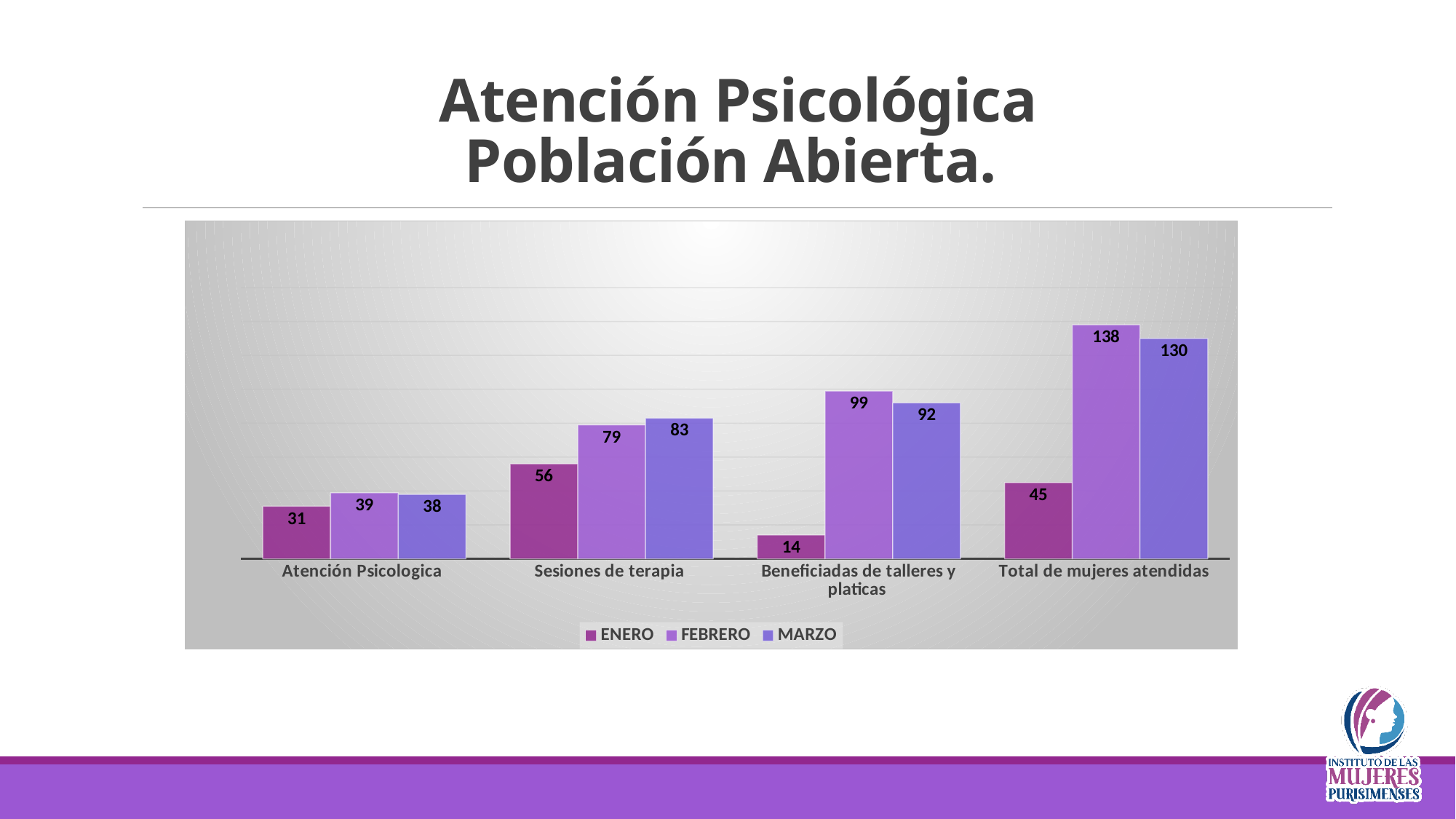
What is the MARZO value for Beneficiadas de talleres y platicas? 92 Which category has the lowest ENERO value? Beneficiadas de talleres y platicas What is the difference between the FEBRERO and MARZO values for Total de mujeres atendidas? 8 What is the difference between the FEBRERO and ENERO values for Beneficiadas de talleres y platicas? 85 What is the FEBRERO value for Total de mujeres atendidas? 138 Which is larger for Sesiones de terapia, the FEBRERO value or the MARZO value? MARZO What is the ENERO value for Sesiones de terapia? 56 Which category has the highest MARZO value? Total de mujeres atendidas How many series does the legend list? 3 Which series is shown in the darkest purple colour in the legend? ENERO What kind of chart is shown on the slide? Bar chart How many categories are shown on the x axis? 4